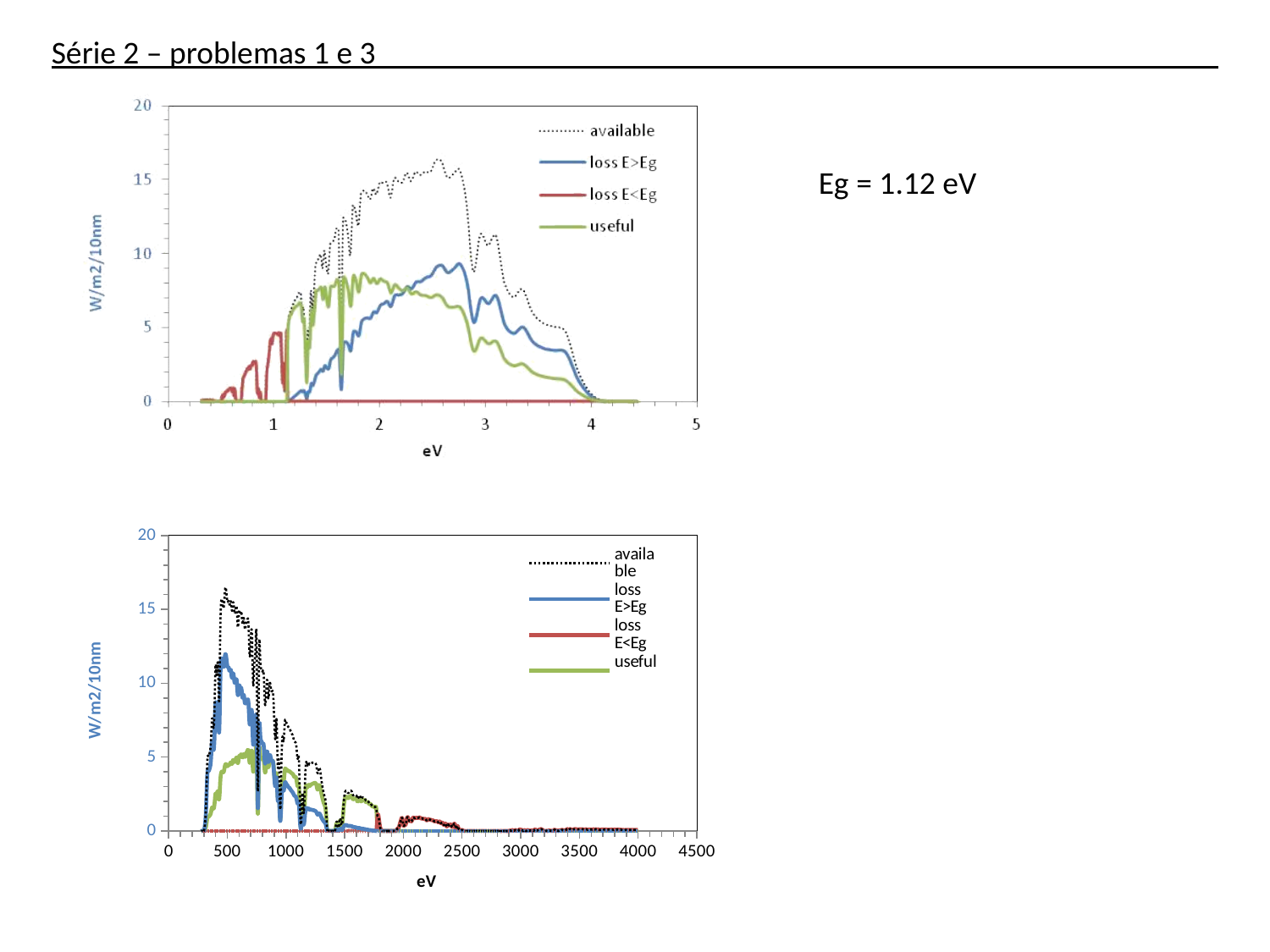
What kind of chart is the bottom chart? line chart In the top chart, does the 'available' series rise or fall between 3 and 4 eV? fall In the bottom chart, is the peak value of the 'loss E>Eg' series greater or less than 10? greater In the bottom chart, how many series does the legend list? 4 What kind of chart is the top chart? line chart What is the y-axis label of the top chart? W/m2/10nm In the top chart, at 2.5 eV, which series has the larger value: 'available' or 'useful'? available In the top chart, is the peak value of the 'available' series greater or less than 15? greater In the top chart, is the peak value of the 'useful' series greater or less than 10? less In the bottom chart, around 500 on the x axis, which series has the larger value: 'loss E>Eg' or 'useful'? loss E>Eg In the top chart, how many series does the legend list? 4